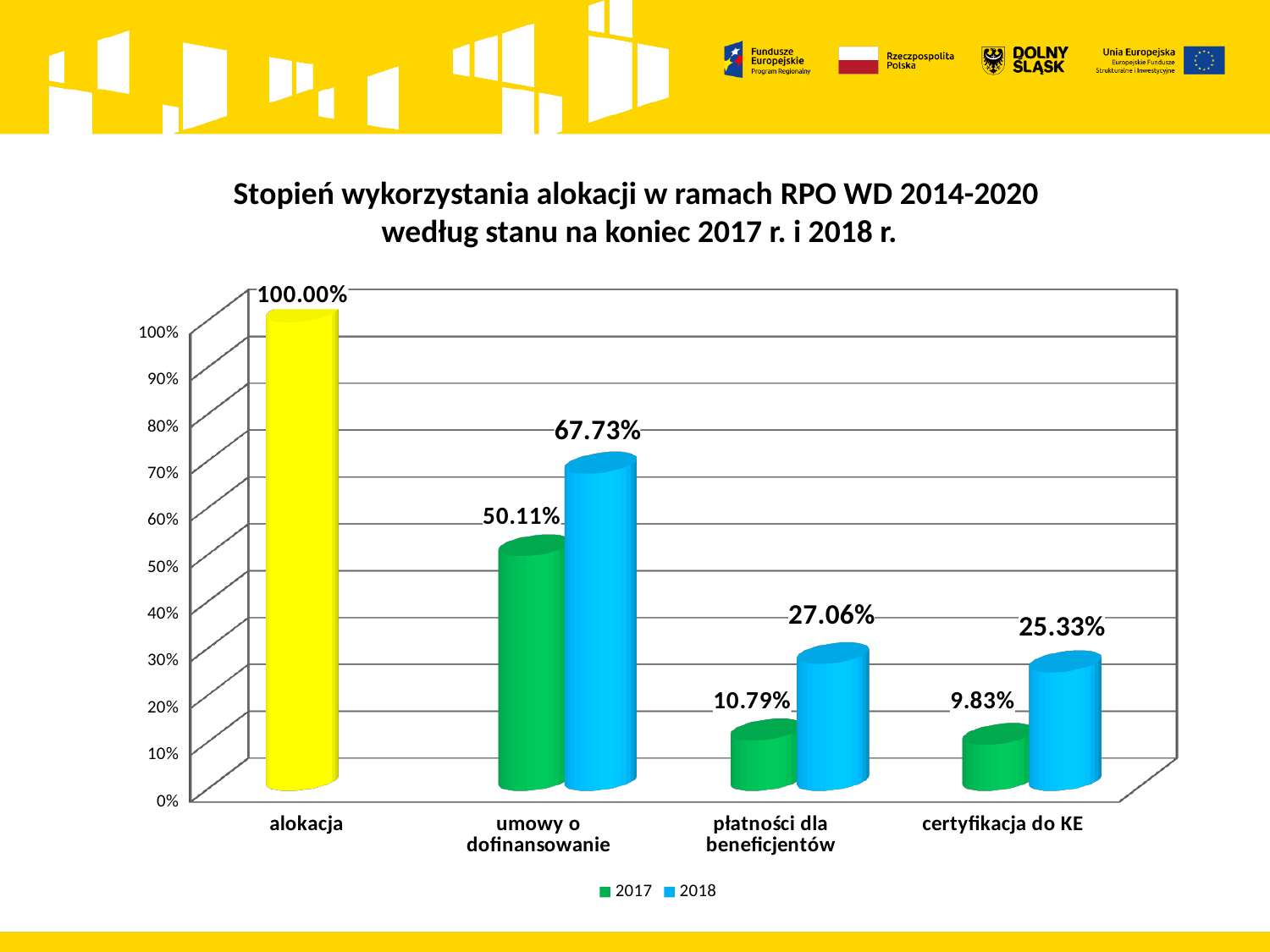
What is the difference between the 2018 and 2017 values for 'umowy o dofinansowanie'? 17.62% How many series does the legend list? 2 What is the value for 2018 in the 'umowy o dofinansowanie' category? 67.73% What kind of chart is shown on the slide? bar chart What is the value for 2017 in the 'płatności dla beneficjentów' category? 10.79% Which is larger: the 2018 value for 'płatności dla beneficjentów' or the 2018 value for 'certyfikacja do KE'? płatności dla beneficjentów Which category has the lowest value for 2017? certyfikacja do KE What value is shown for the 'alokacja' category? 100.00% Among the 2018 bars, which category has the highest value? umowy o dofinansowanie How many categories are shown on the x axis? 4 What is the value for 2018 in the 'certyfikacja do KE' category? 25.33% What is the difference between the 2018 and 2017 values for 'płatności dla beneficjentów'? 16.27%